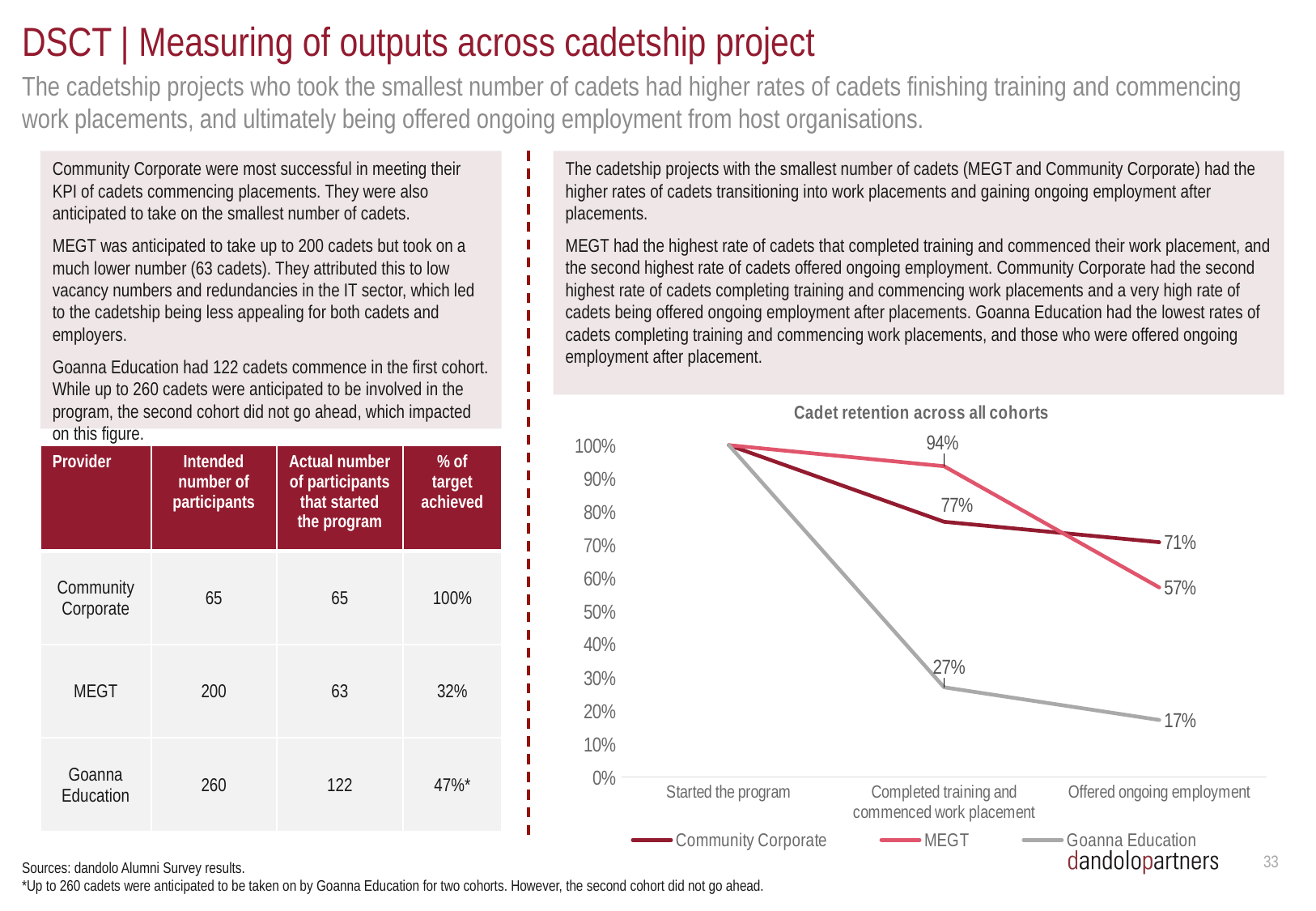
In the 'Cadet retention across all cohorts' chart, what colour is the Goanna Education line? grey In the 'Cadet retention across all cohorts' chart, what is the value for Goanna Education at 'Completed training and commenced work placement'? 27% In the 'Cadet retention across all cohorts' chart, what is the difference between MEGT's value at 'Completed training and commenced work placement' and at 'Offered ongoing employment'? 37% What type of chart is 'Cadet retention across all cohorts'? line chart In the 'Cadet retention across all cohorts' chart, which is larger at 'Offered ongoing employment': Community Corporate or MEGT? Community Corporate In the 'Cadet retention across all cohorts' chart, what is the value for MEGT at 'Completed training and commenced work placement'? 94% In the 'Cadet retention across all cohorts' chart, what is the value for Community Corporate at 'Offered ongoing employment'? 71% How many series does the legend of the 'Cadet retention across all cohorts' chart list? 3 How many stages are shown on the x axis of the 'Cadet retention across all cohorts' chart? 3 In the 'Cadet retention across all cohorts' chart, which provider has the highest value at 'Completed training and commenced work placement'? MEGT In the 'Cadet retention across all cohorts' chart, do the values for Goanna Education rise or fall across the stages? fall In the 'Cadet retention across all cohorts' chart, which provider has the lowest value at 'Offered ongoing employment'? Goanna Education